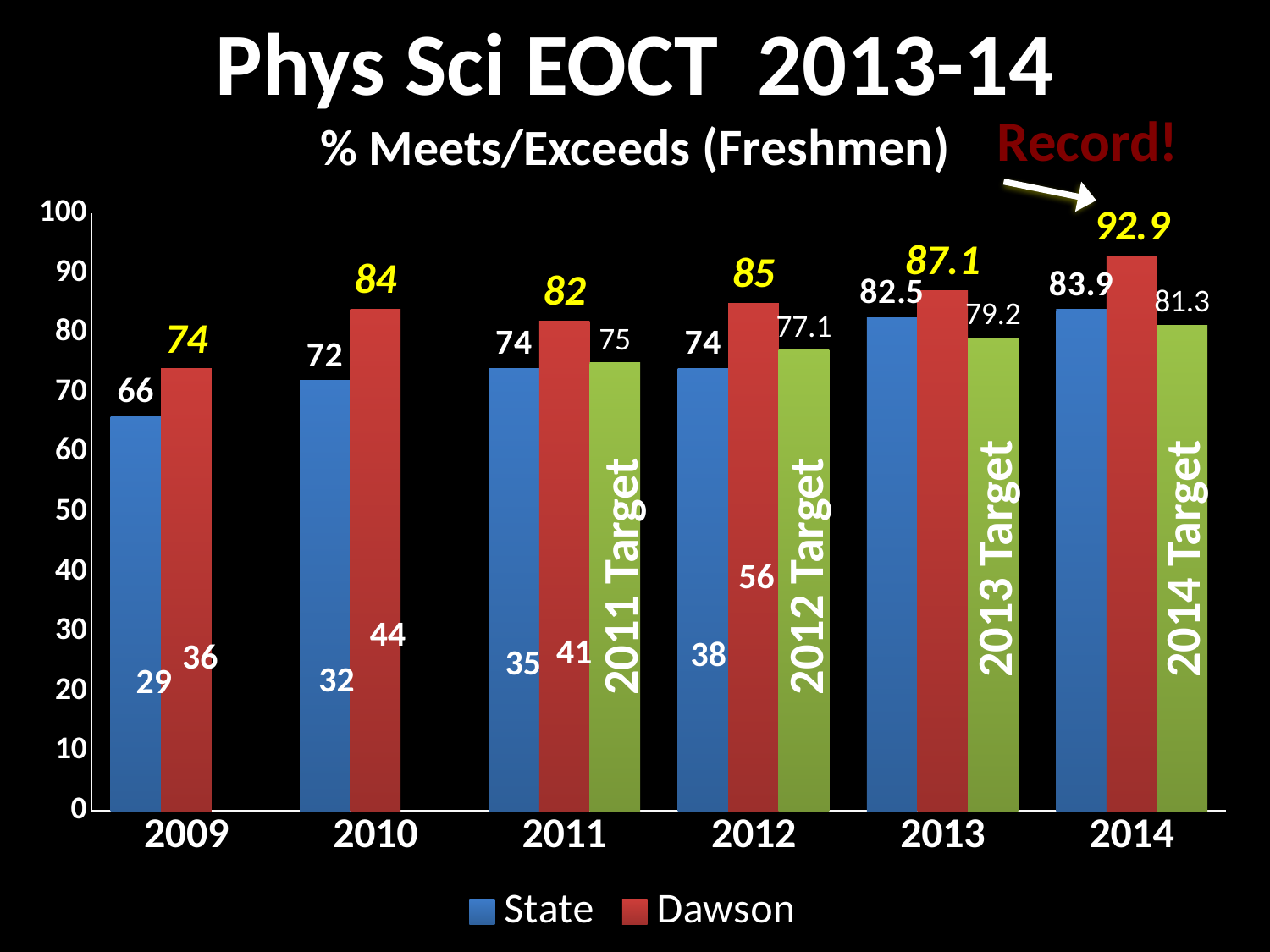
In which year is the State value lowest? 2009 What is the State value for 2013? 82.5 What is the State value for 2009? 66 How many years are shown on the x axis? 6 How many series does the legend list? 2 What is the difference between the Dawson value and the Target value in 2013? 7.9 What kind of chart is shown on the slide? Bar chart What is the 2012 Target value? 77.1 What is the Dawson value for 2014? 92.9 In which year is the Dawson value highest? 2014 Which is larger in 2011, the Dawson value or the 2011 Target? Dawson What is the difference between the Dawson and State values in 2014? 9